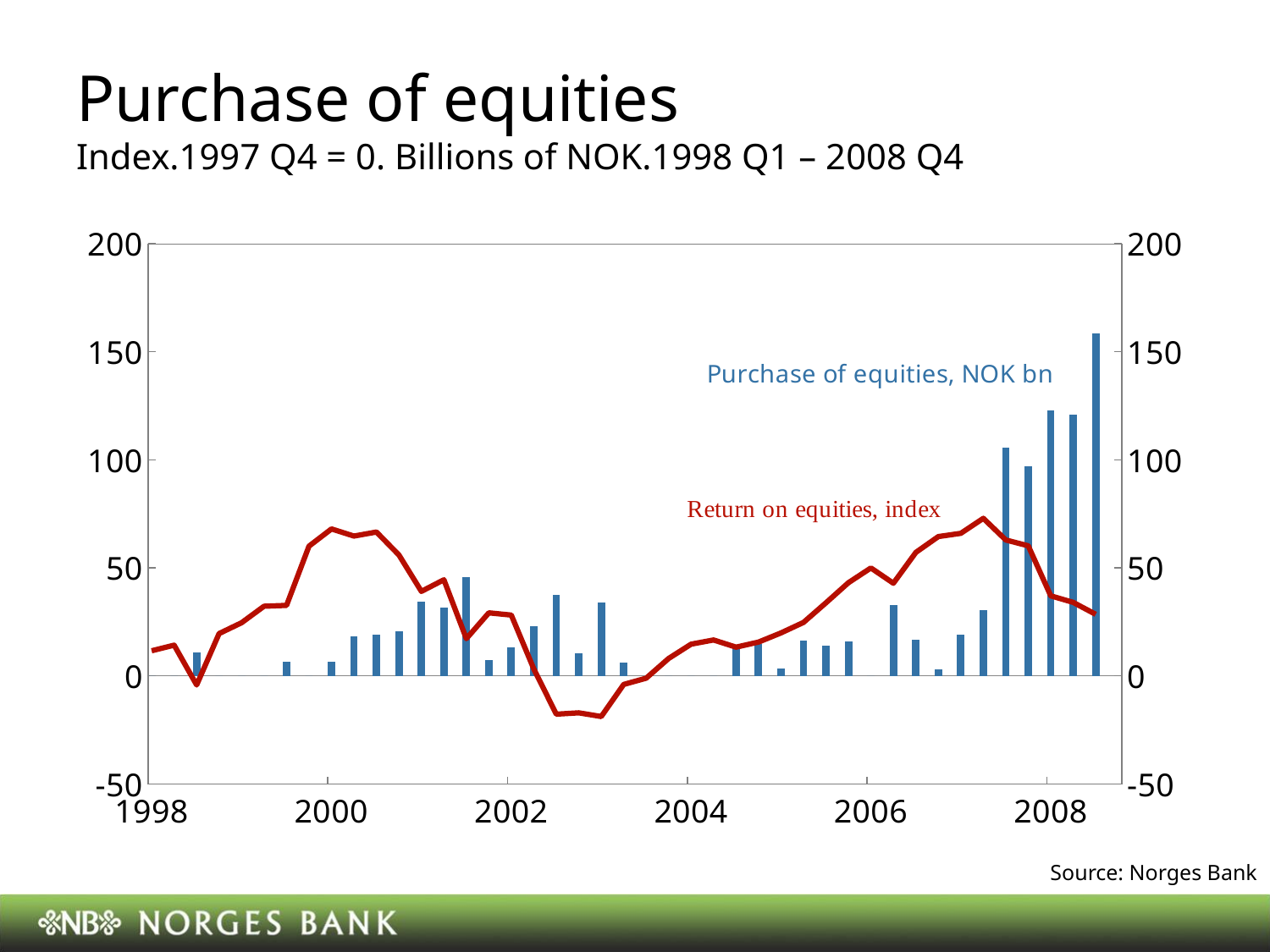
Which series is drawn as a red line? Return on equities, index Is the peak of the Return on equities index around 2000 greater or less than 50? greater Which series is drawn as bars? Purchase of equities, NOK bn Is the peak of the Return on equities index around 2000 greater or less than 100? less Is the Return on equities index at the end of 2008 greater or less than 50? less Does the Return on equities index rise or fall from 2007 to the end of 2008? fall Do the Purchase of equities bars rise or fall from 2007 to the end of 2008? rise In which year does the tallest bar for Purchase of equities occur? 2008 How many data series are labelled on the chart? 2 What kind of chart is shown on the slide? A combined bar and line chart